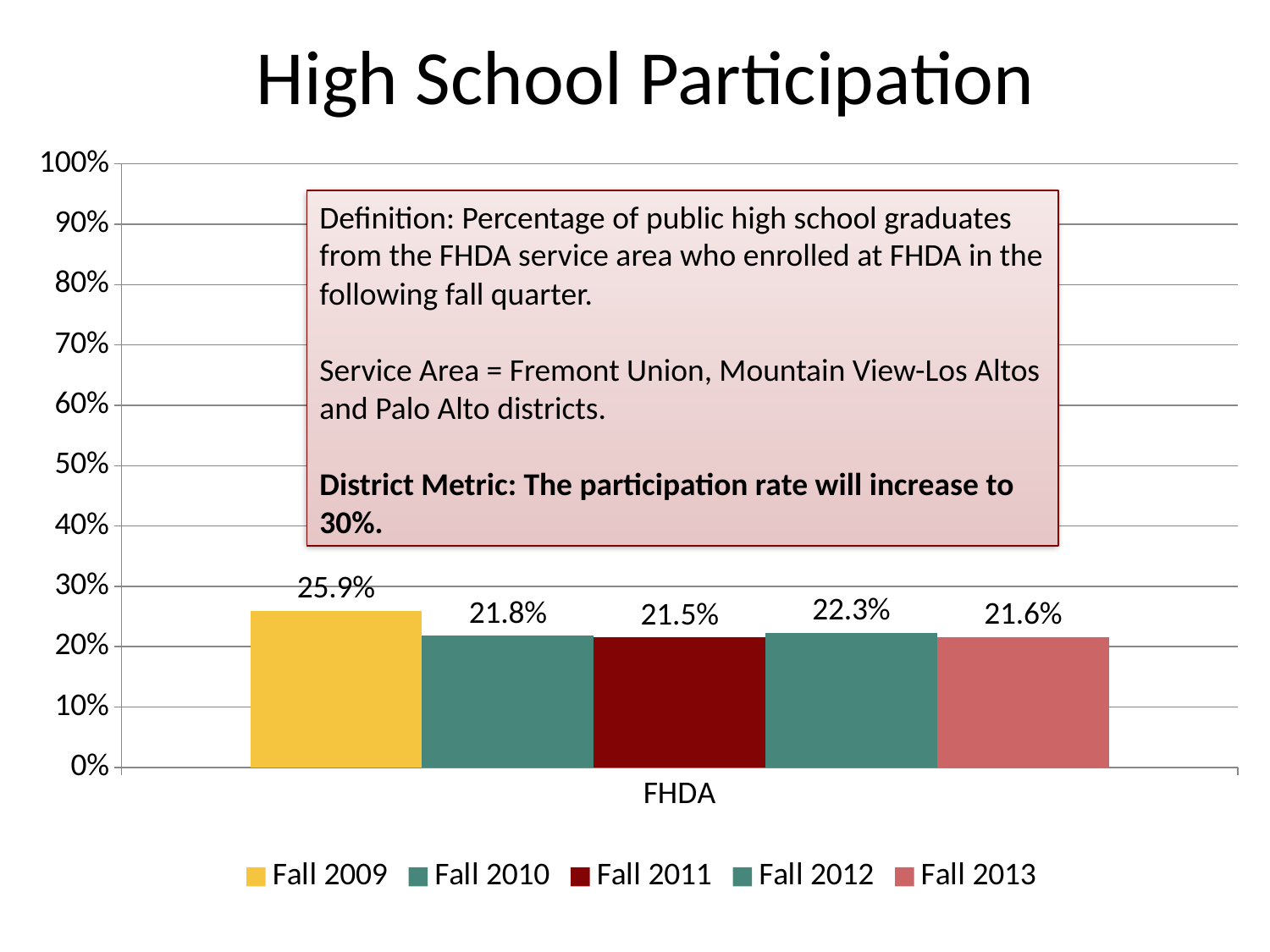
What is the title of the chart? High School Participation Which series has the lowest participation rate? Fall 2011 What is the participation rate for Fall 2013? 21.6% Which is larger, the Fall 2009 rate or the Fall 2013 rate? Fall 2009 What is the difference between the Fall 2012 and Fall 2011 participation rates? 0.8% Which series has the highest participation rate? Fall 2009 Is the value for Fall 2009 greater or less than 30%? less What is the participation rate for Fall 2009? 25.9% What kind of chart is shown on the slide? bar chart What is the difference between the Fall 2009 and Fall 2010 participation rates? 4.1% How many series does the legend list? 5 What is the participation rate for Fall 2012? 22.3%